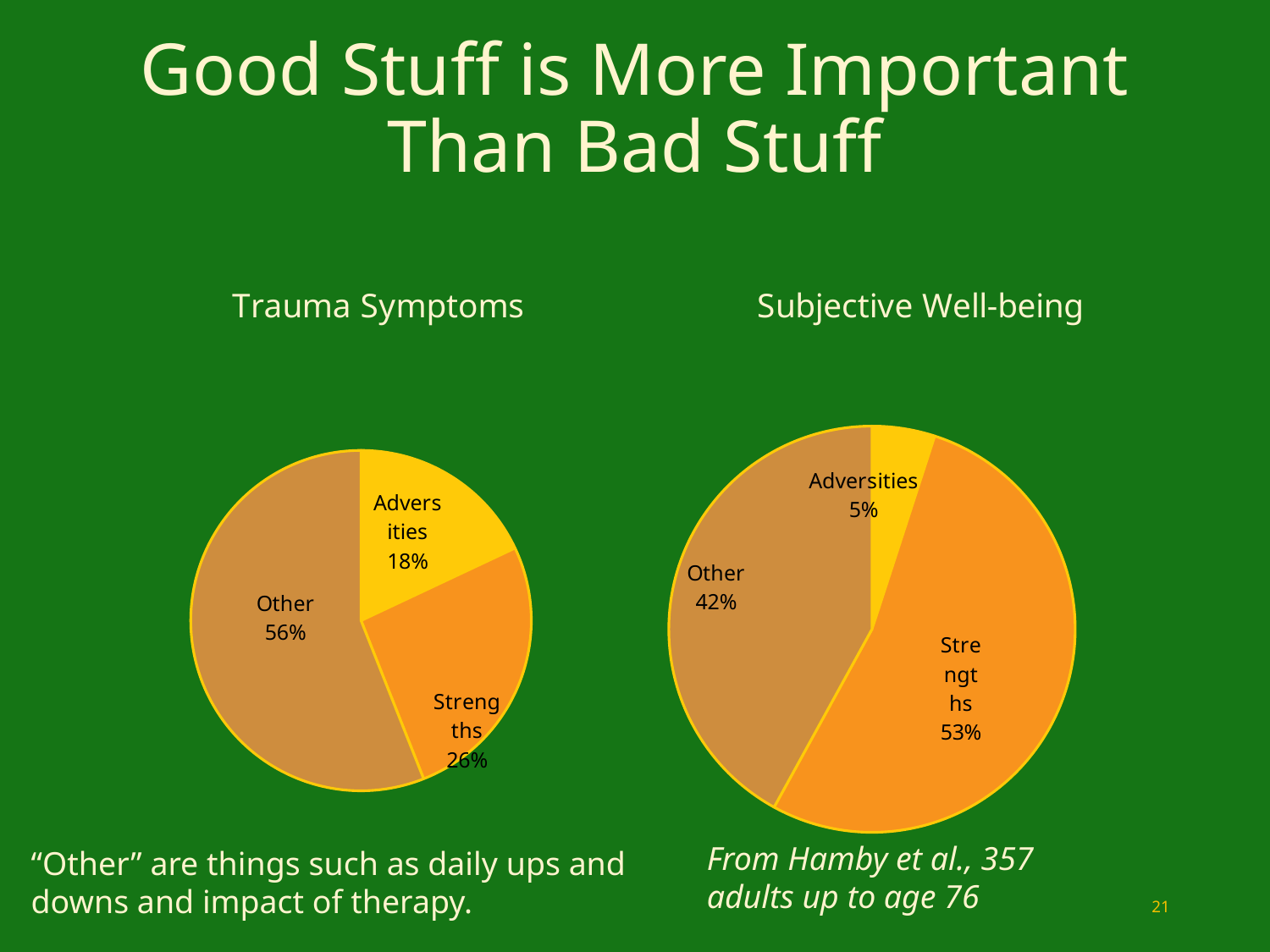
In the Trauma Symptoms chart, which slice is the smallest? Adversities In the Subjective Well-being chart, what is the difference in percentage points between Strengths and Other? 11 In the Trauma Symptoms chart, what percentage is labelled for Adversities? 18% In the Subjective Well-being chart, what percentage is labelled for Adversities? 5% In the Trauma Symptoms chart, which is larger, Strengths or Adversities? Strengths How many slices does the Subjective Well-being pie chart have? 3 What type of chart is the Trauma Symptoms chart? Pie chart In the Trauma Symptoms chart, what is the difference in percentage points between Other and Strengths? 30 In the Subjective Well-being chart, which slice is the largest? Strengths In the Trauma Symptoms chart, what percentage is labelled for Other? 56% In the Subjective Well-being chart, what percentage is labelled for Strengths? 53% What is the title of the chart on the right side of the slide? Subjective Well-being